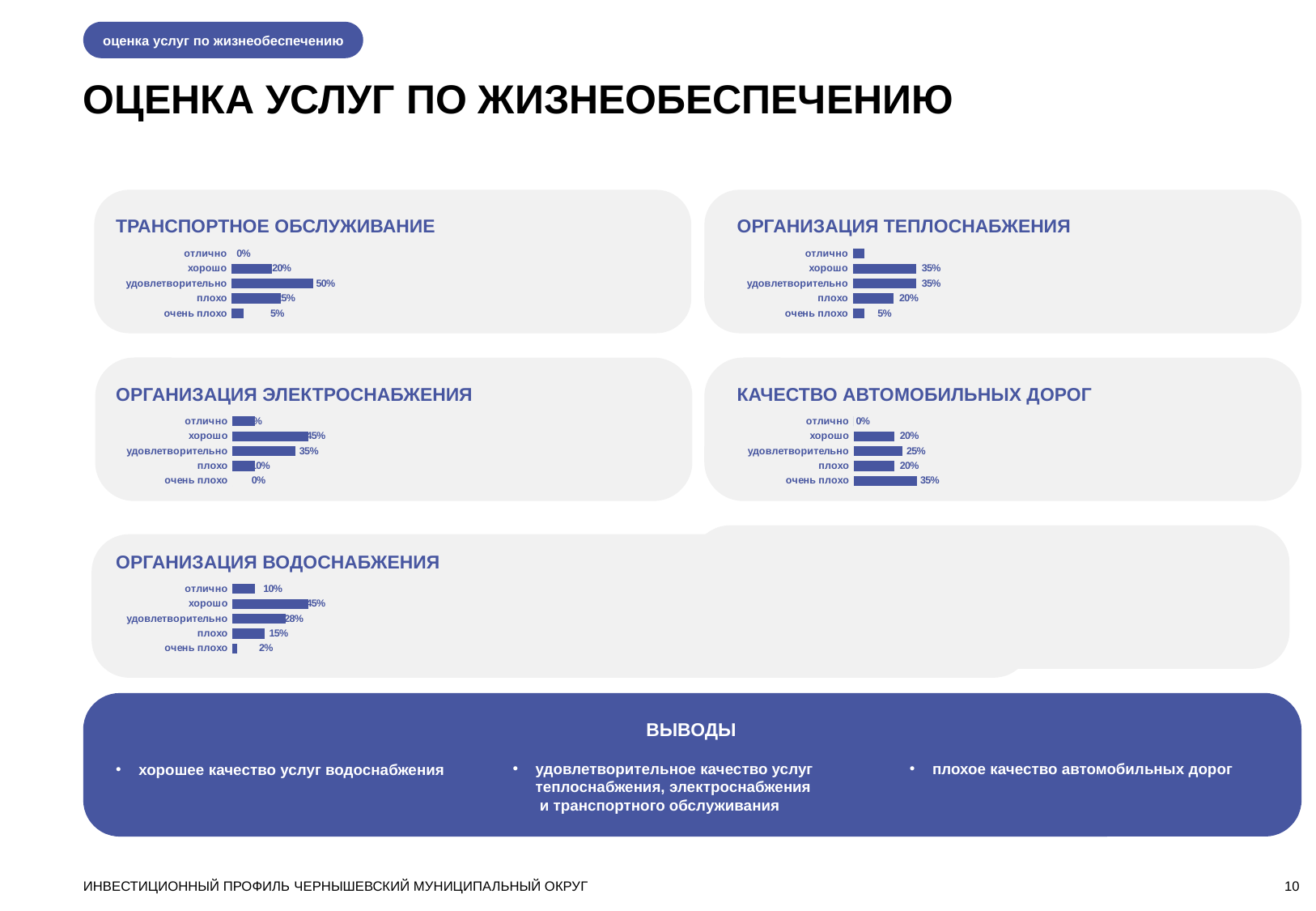
In the ОРГАНИЗАЦИЯ ТЕПЛОСНАБЖЕНИЯ chart, what is the difference between хорошо and очень плохо? 30% In the ТРАНСПОРТНОЕ ОБСЛУЖИВАНИЕ chart, what is the value for удовлетворительно? 50% In the ОРГАНИЗАЦИЯ ВОДОСНАБЖЕНИЯ chart, what is the difference between хорошо and удовлетворительно? 17% In the ОРГАНИЗАЦИЯ ЭЛЕКТРОСНАБЖЕНИЯ chart, what is the value for хорошо? 45% In the КАЧЕСТВО АВТОМОБИЛЬНЫХ ДОРОГ chart, what is the value for удовлетворительно? 25% What type of chart is used for ОРГАНИЗАЦИЯ ТЕПЛОСНАБЖЕНИЯ? Bar chart In the ТРАНСПОРТНОЕ ОБСЛУЖИВАНИЕ chart, which category has the highest value? удовлетворительно In the ОРГАНИЗАЦИЯ ВОДОСНАБЖЕНИЯ chart, what is the value for очень плохо? 2% In the КАЧЕСТВО АВТОМОБИЛЬНЫХ ДОРОГ chart, which category has the highest value? очень плохо In the ОРГАНИЗАЦИЯ ТЕПЛОСНАБЖЕНИЯ chart, what is the value for плохо? 20% In the ОРГАНИЗАЦИЯ ЭЛЕКТРОСНАБЖЕНИЯ chart, which is larger, хорошо or удовлетворительно? хорошо How many categories does the ОРГАНИЗАЦИЯ ВОДОСНАБЖЕНИЯ chart show? 5